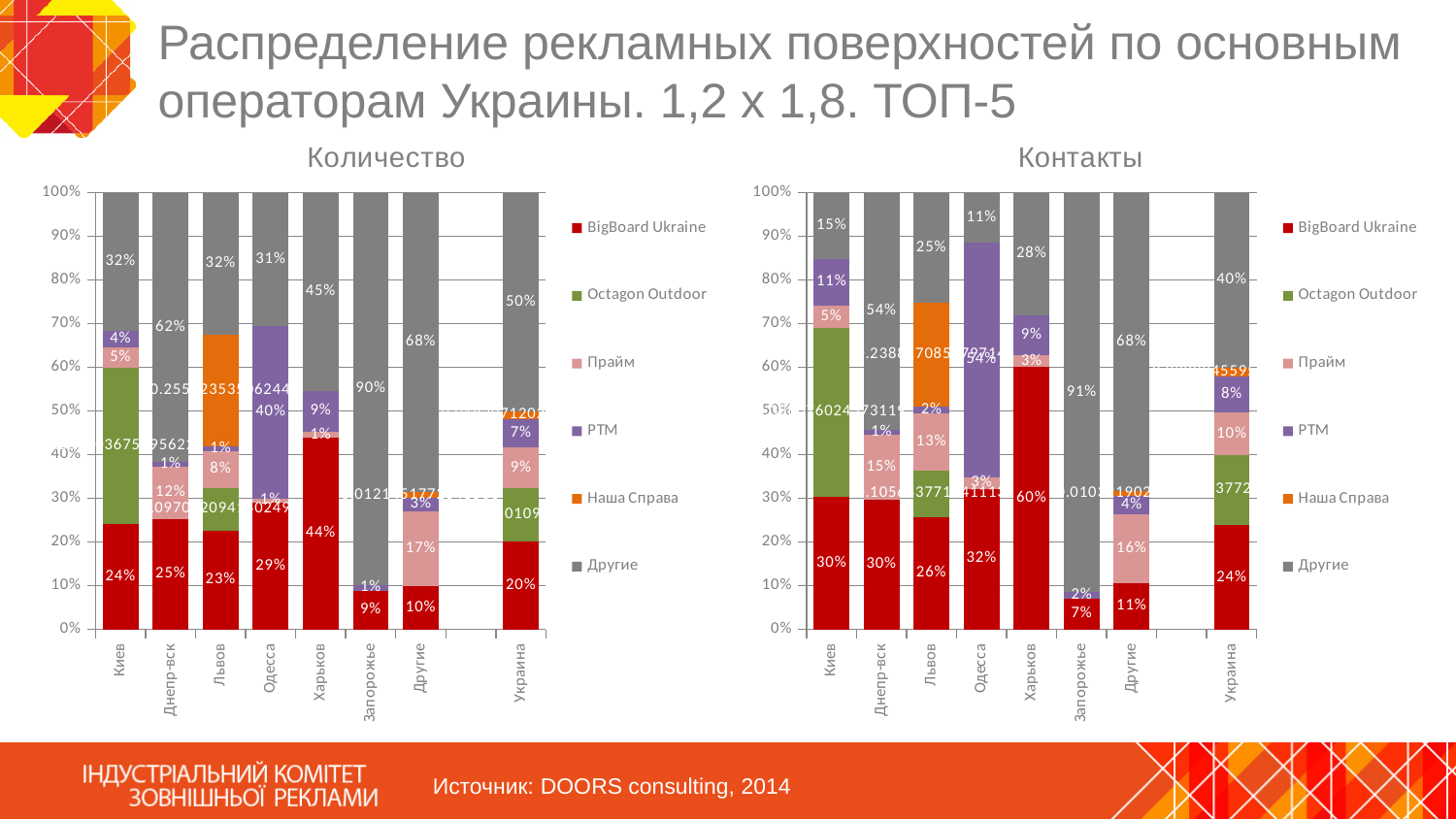
What type of chart is the Количество chart? Stacked bar chart In the Количество chart, which city has the highest BigBoard Ukraine share? Харьков In the Количество chart, what is the difference between the Другие share for Днепр-вск (62%) and for Киев (32%)? 30% How many series does the legend of the Контакты chart list? 6 What is the title of the chart on the right side of the slide? Контакты In the Контакты chart, which is larger: the PTM share for Одесса or the PTM share for Харьков? Одесса In the Контакты chart, what is the Другие share for Украина? 40% How many categories are shown on the x axis of the Количество chart? 8 In the Количество chart, what is the Другие share for Запорожье? 90% In the Контакты chart, which category has the lowest BigBoard Ukraine share? Запорожье In the Количество chart, what is the BigBoard Ukraine share for Харьков? 44% In the Контакты chart, what is the BigBoard Ukraine share for Харьков? 60%